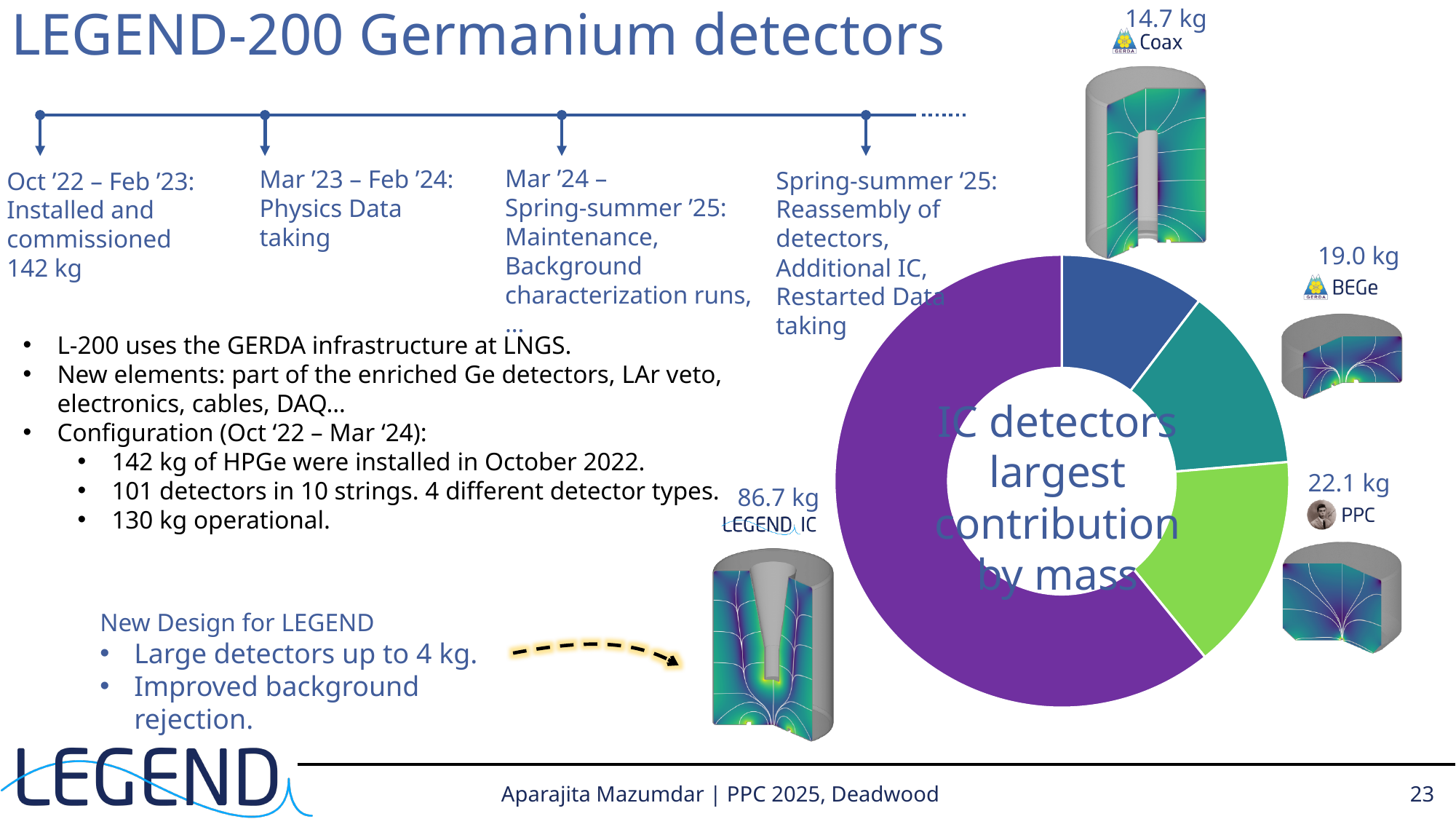
What is the mass of the PPC detectors in the donut chart? 22.1 kg What is the mass of the IC detectors in the donut chart? 86.7 kg What is the difference in mass between the PPC and BEGe detectors in the donut chart? 3.1 kg Which has a larger mass in the donut chart, PPC or BEGe? PPC How many detector types (segments) does the donut chart show? 4 What is the mass of the Coax detectors in the donut chart? 14.7 kg What kind of chart is shown on the right of the slide? pie (donut) chart What is the difference in mass between the IC and PPC detectors in the donut chart? 64.6 kg Which detector type has the largest mass in the donut chart? IC What text is written in the centre of the donut chart? IC detectors largest contribution by mass What is the mass of the BEGe detectors in the donut chart? 19.0 kg Which detector type has the smallest mass in the donut chart? Coax